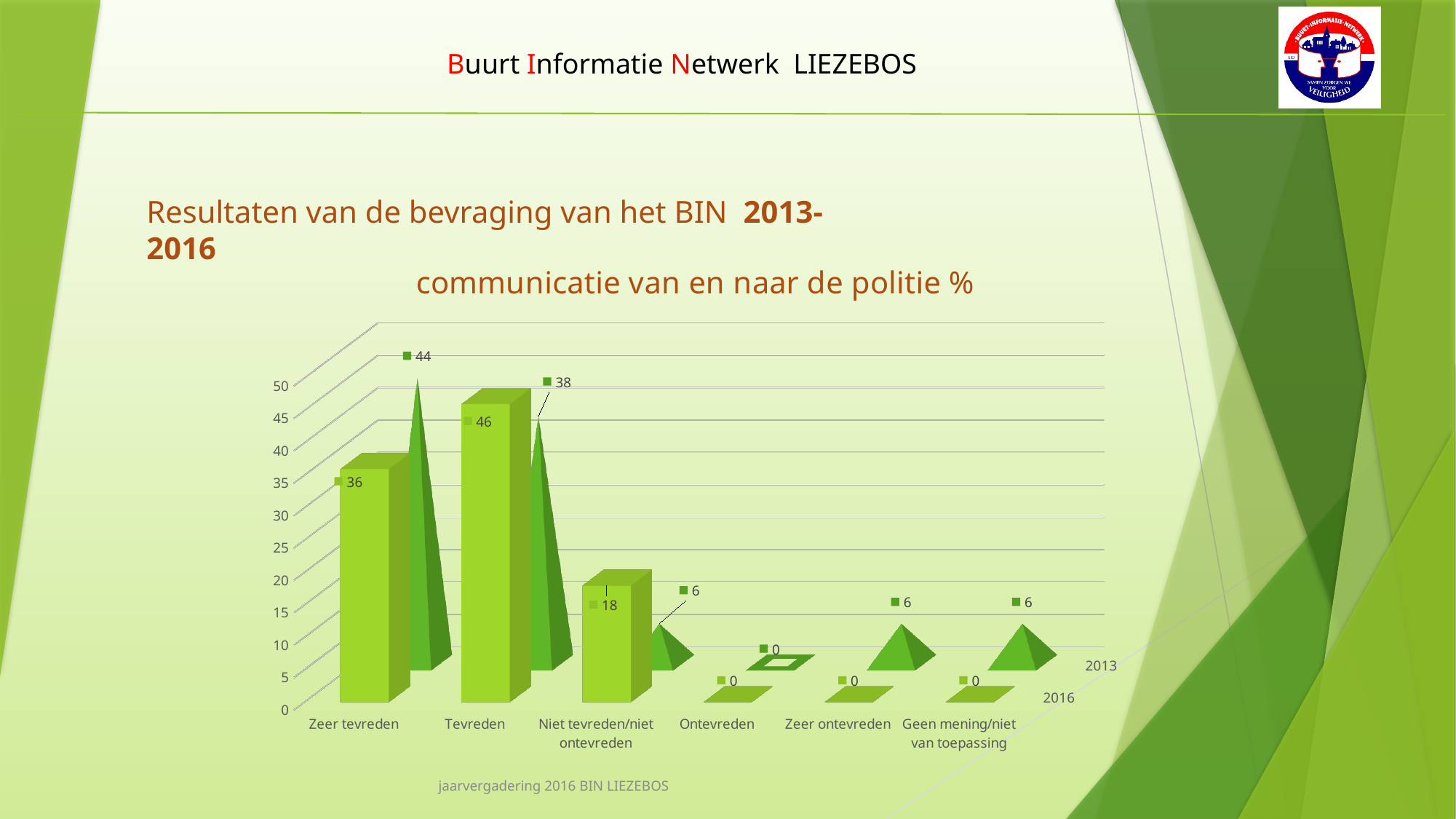
What is the 2013 value for Zeer tevreden? 44 Which category has the highest 2016 value? Tevreden Which is larger for Zeer tevreden: the 2013 value or the 2016 value? 2013 How many series does the chart show? 2 What is the 2013 value for Geen mening/niet van toepassing? 6 What is the 2016 value for Tevreden? 46 Which category has the highest 2013 value? Zeer tevreden How many categories are shown on the x axis? 6 What kind of chart is shown on the slide? Bar chart What is the difference between the 2016 and 2013 values for Tevreden? 8 What is the title of the chart? communicatie van en naar de politie % What is the 2016 value for Niet tevreden/niet ontevreden? 18